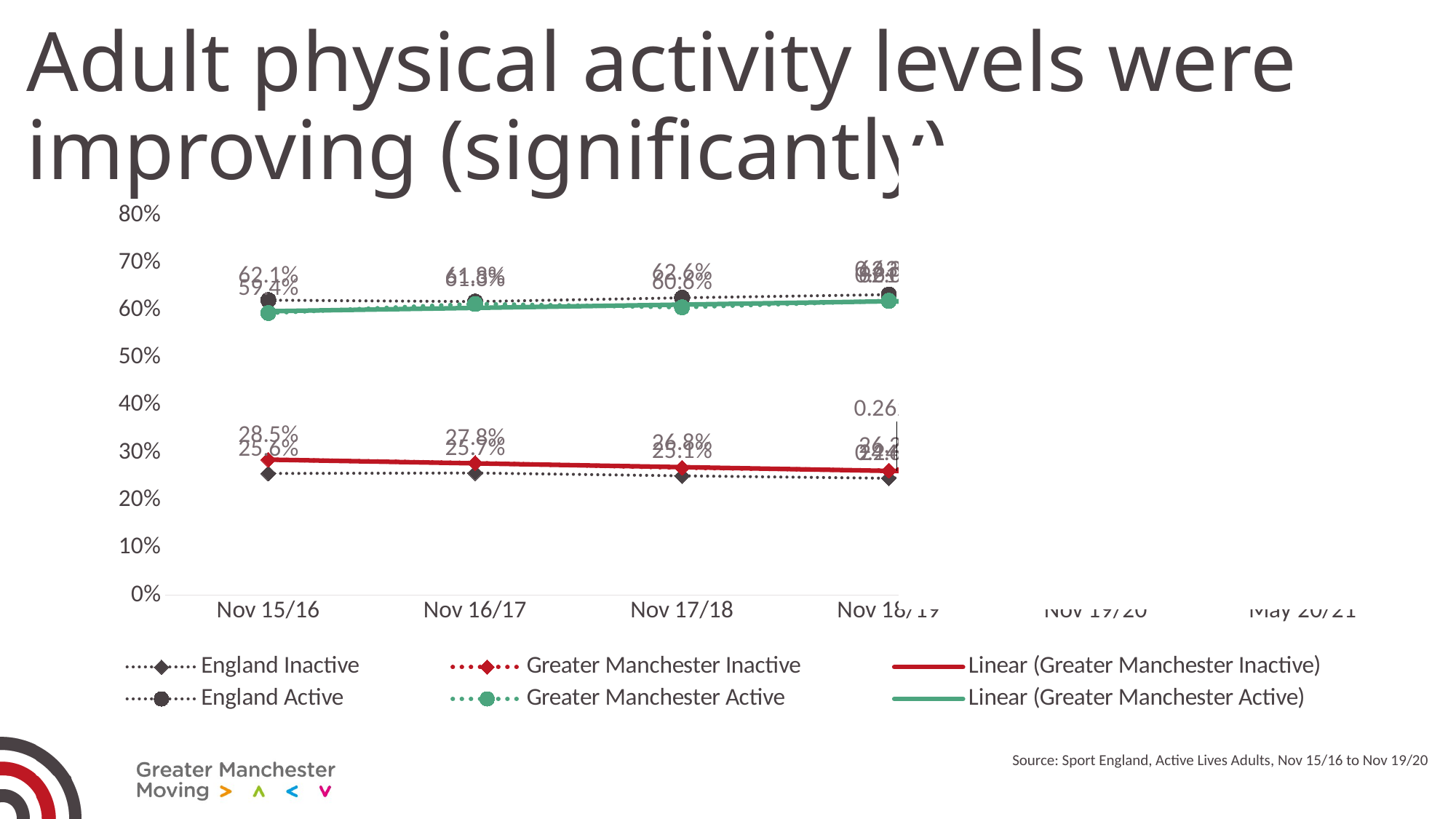
What is the difference between England Active and Greater Manchester Active in Nov 15/16? 2.7 percentage points How many series does the legend list? 6 What is the value for England Active in Nov 15/16? 62.1% Is the value for Greater Manchester Active in Nov 17/18 greater or less than 50%? greater What is the value for Greater Manchester Inactive in Nov 15/16? 28.5% What is the value for Greater Manchester Inactive in Nov 16/17? 27.8% What is the value for Greater Manchester Active in Nov 15/16? 59.4% Which is larger in Nov 17/18: Greater Manchester Inactive or England Inactive? Greater Manchester Inactive What is the value for England Inactive in Nov 17/18? 25.1% Does the Greater Manchester Inactive series rise or fall from Nov 15/16 to Nov 18/19? fall Does the Greater Manchester Active series rise or fall from Nov 15/16 to Nov 18/19? rise What type of chart is shown on the slide? line chart